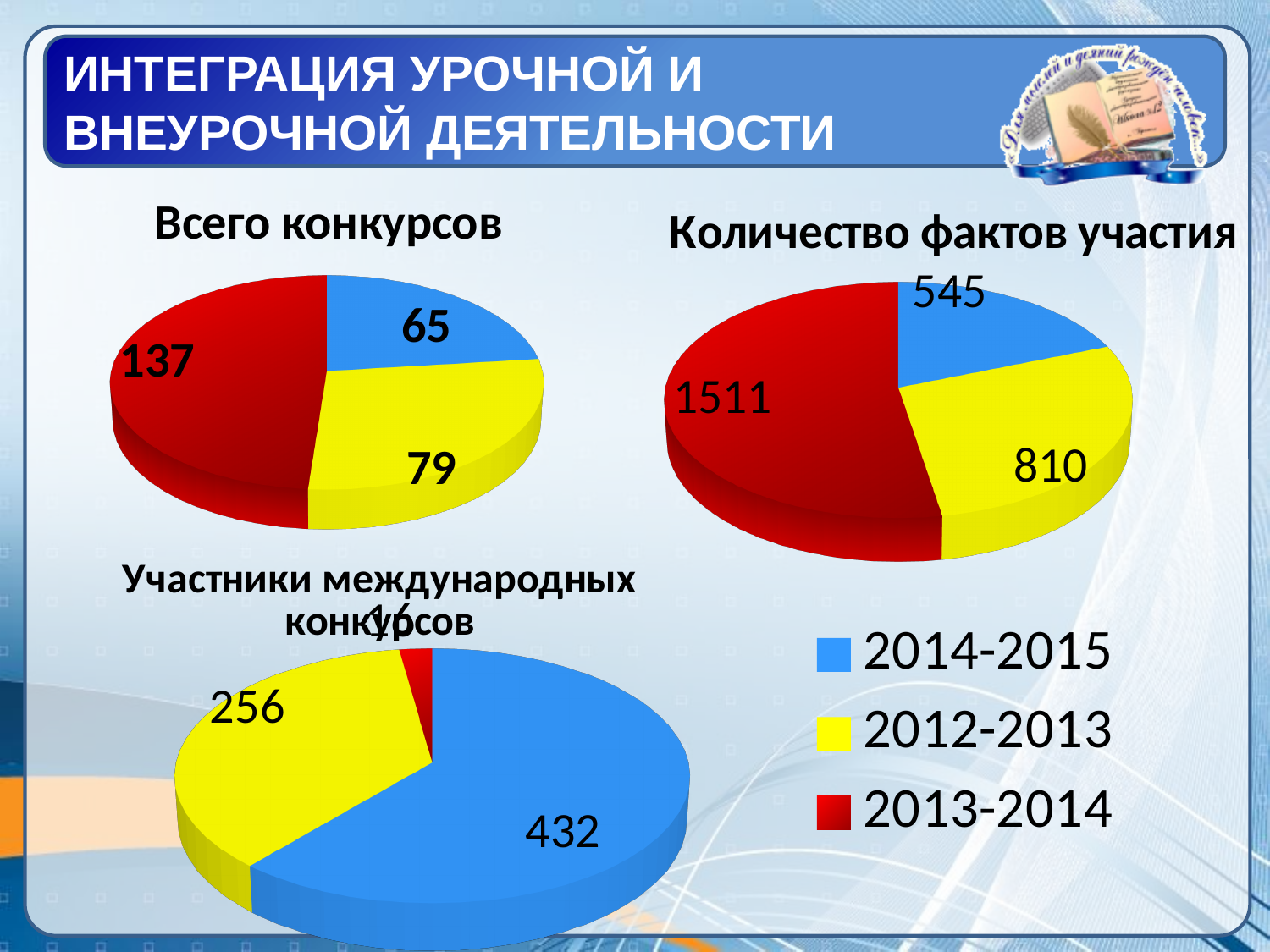
In the 'Участники международных конкурсов' chart, which year has the largest slice? 2014-2015 In the 'Количество фактов участия' chart, which year has the highest value? 2013-2014 In the 'Участники международных конкурсов' chart, what is the value for 2014-2015? 432 In the 'Всего конкурсов' chart, what is the value for 2013-2014? 137 In the 'Всего конкурсов' chart, which year has the lowest value? 2014-2015 What type of chart is used for 'Количество фактов участия'? Pie chart In the 'Всего конкурсов' chart, what is the value for 2014-2015? 65 How many entries does the legend list? 3 In the 'Всего конкурсов' chart, what is the difference between the 2012-2013 and 2014-2015 values? 14 In the 'Участники международных конкурсов' chart, which is larger: the value for 2014-2015 or for 2012-2013? 2014-2015 In the 'Количество фактов участия' chart, what is the difference between the 2013-2014 and 2014-2015 values? 966 In the 'Количество фактов участия' chart, what is the value for 2012-2013? 810